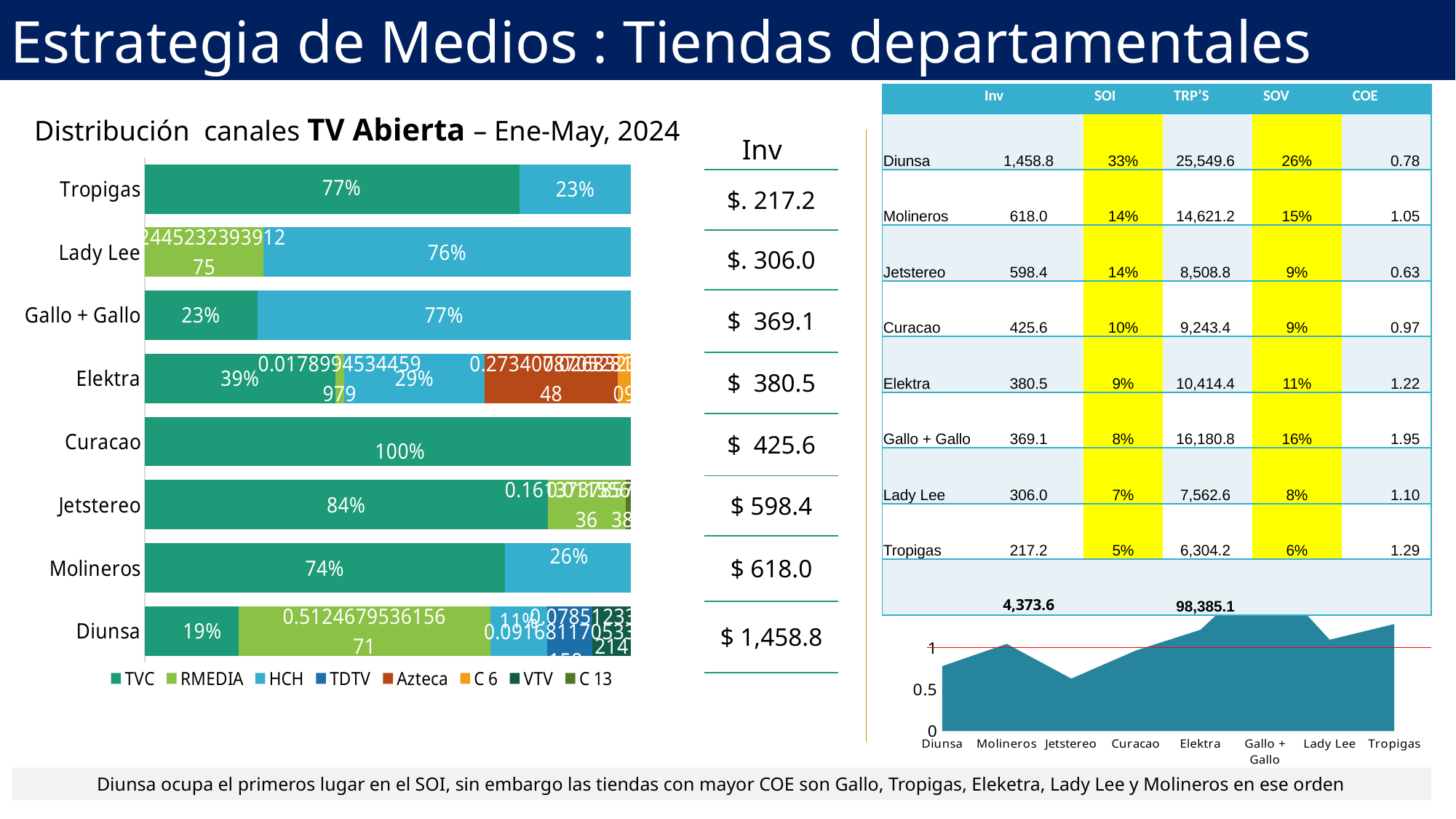
In the area chart at the bottom right of the slide, is the value for Jetstereo greater or less than 1? less In the 'Distribución canales TV Abierta' chart, which is larger: the HCH share for Lady Lee or the HCH share for Elektra? Lady Lee In the 'Distribución canales TV Abierta' chart, what is the HCH share for Gallo + Gallo? 77% How many stores are shown in the 'Distribución canales TV Abierta' chart? 8 In the 'Distribución canales TV Abierta' chart, what is the difference between the TVC share of Jetstereo and the TVC share of Molineros? 10% In the 'Distribución canales TV Abierta' chart, which store has the highest TVC share? Curacao In the 'Distribución canales TV Abierta' chart, what is the TVC share for Tropigas? 77% In the 'Distribución canales TV Abierta' chart, what is the TVC share for Curacao? 100% How many series does the legend of the 'Distribución canales TV Abierta' chart list? 8 In the area chart at the bottom right of the slide, which store has the highest value? Gallo + Gallo In the 'Distribución canales TV Abierta' chart, what is the HCH share for Molineros? 26%